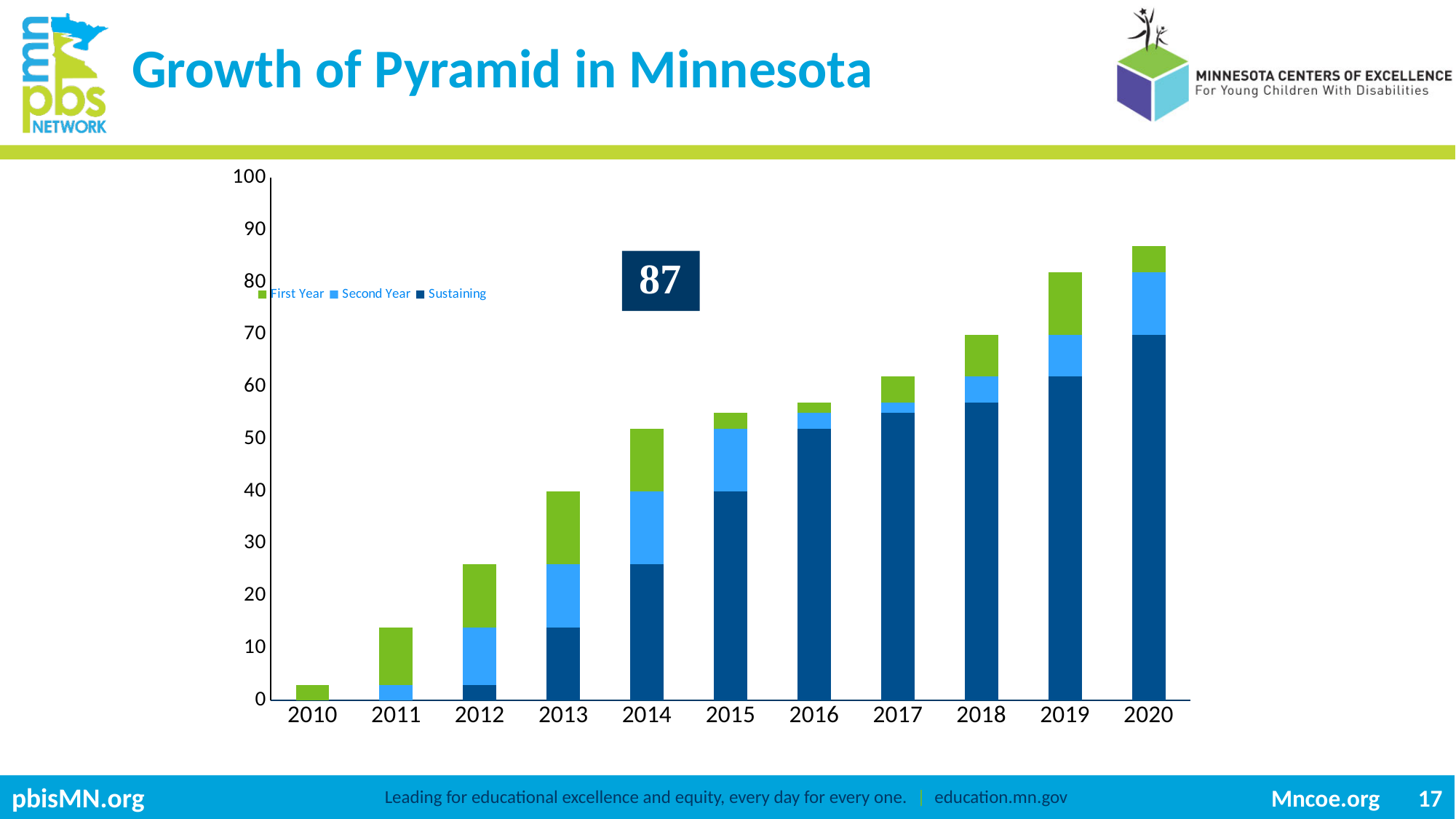
Which year has the larger total bar, 2015 or 2019? 2019 Which year has the shortest stacked bar in the chart? 2010 Is the Sustaining segment for 2020 greater or less than 60? greater How many series does the chart legend list? 3 What are the three series named in the chart legend? First Year, Second Year, Sustaining How many years are shown along the x axis of the chart? 11 Do the total bar heights generally rise or fall from 2010 to 2020? Rise What kind of chart is shown on the slide? Stacked bar chart Which year has the tallest stacked bar in the chart? 2020 Is the total bar height for 2010 greater or less than 10? less Is the total bar height for 2020 greater or less than 80? greater